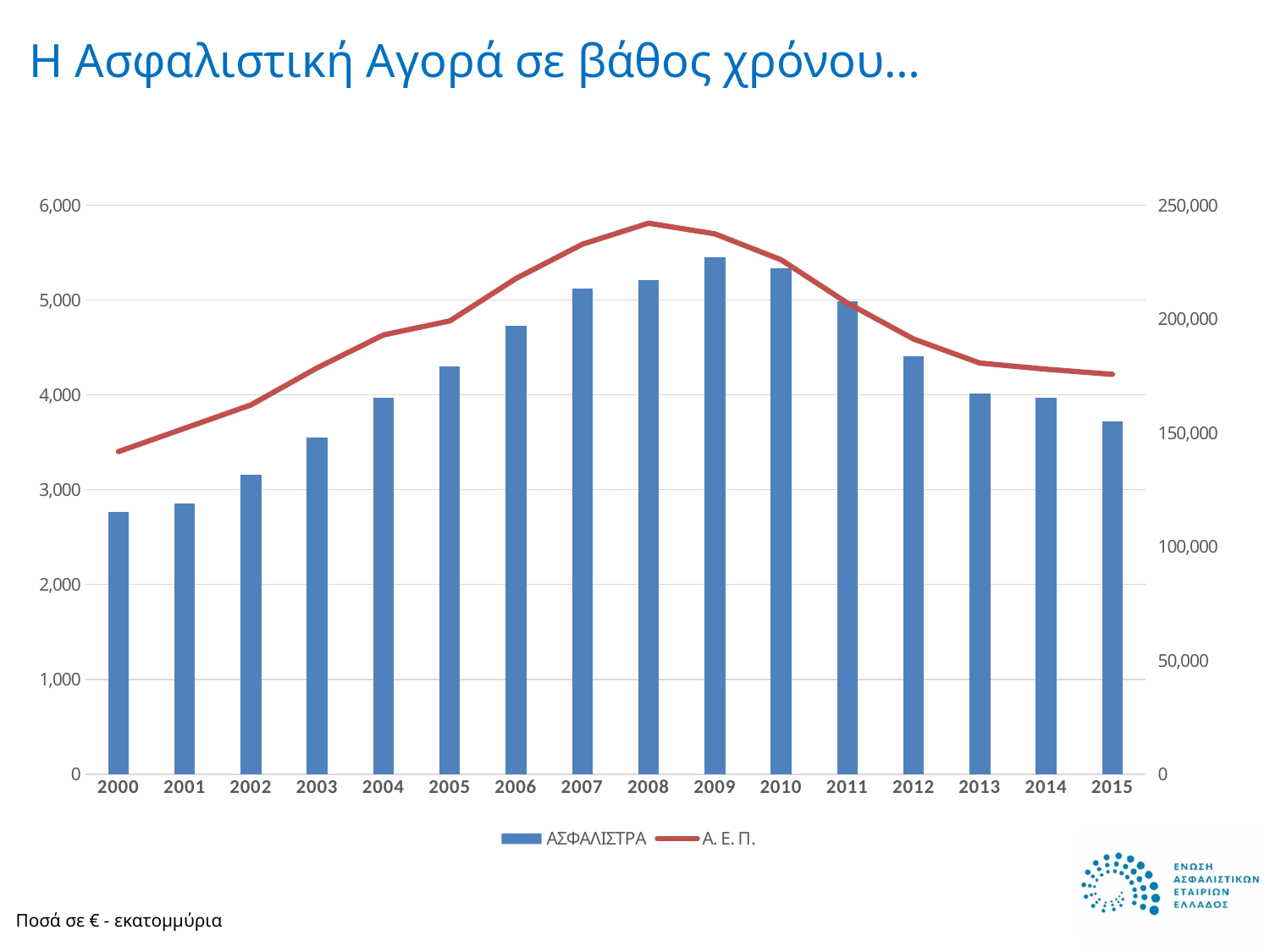
Is the ΑΣΦΑΛΙΣΤΡΑ value for 2009 greater or less than 5,000? greater Which year has the highest ΑΣΦΑΛΙΣΤΡΑ bar? 2009 What kind of chart is shown on the slide? A combination chart with bars and a line Is the ΑΣΦΑΛΙΣΤΡΑ value for 2000 greater or less than 3,000? less Which year has the lowest ΑΣΦΑΛΙΣΤΡΑ bar? 2000 In which year does the Α. Ε. Π. line reach its peak? 2008 How many series does the legend list? 2 How do the ΑΣΦΑΛΙΣΤΡΑ bars change from 2009 to 2015? They fall Which year has the larger ΑΣΦΑΛΙΣΤΡΑ bar, 2003 or 2007? 2007 How many years are shown on the x axis? 16 Is the Α. Ε. Π. value for 2000 greater or less than 150,000? less